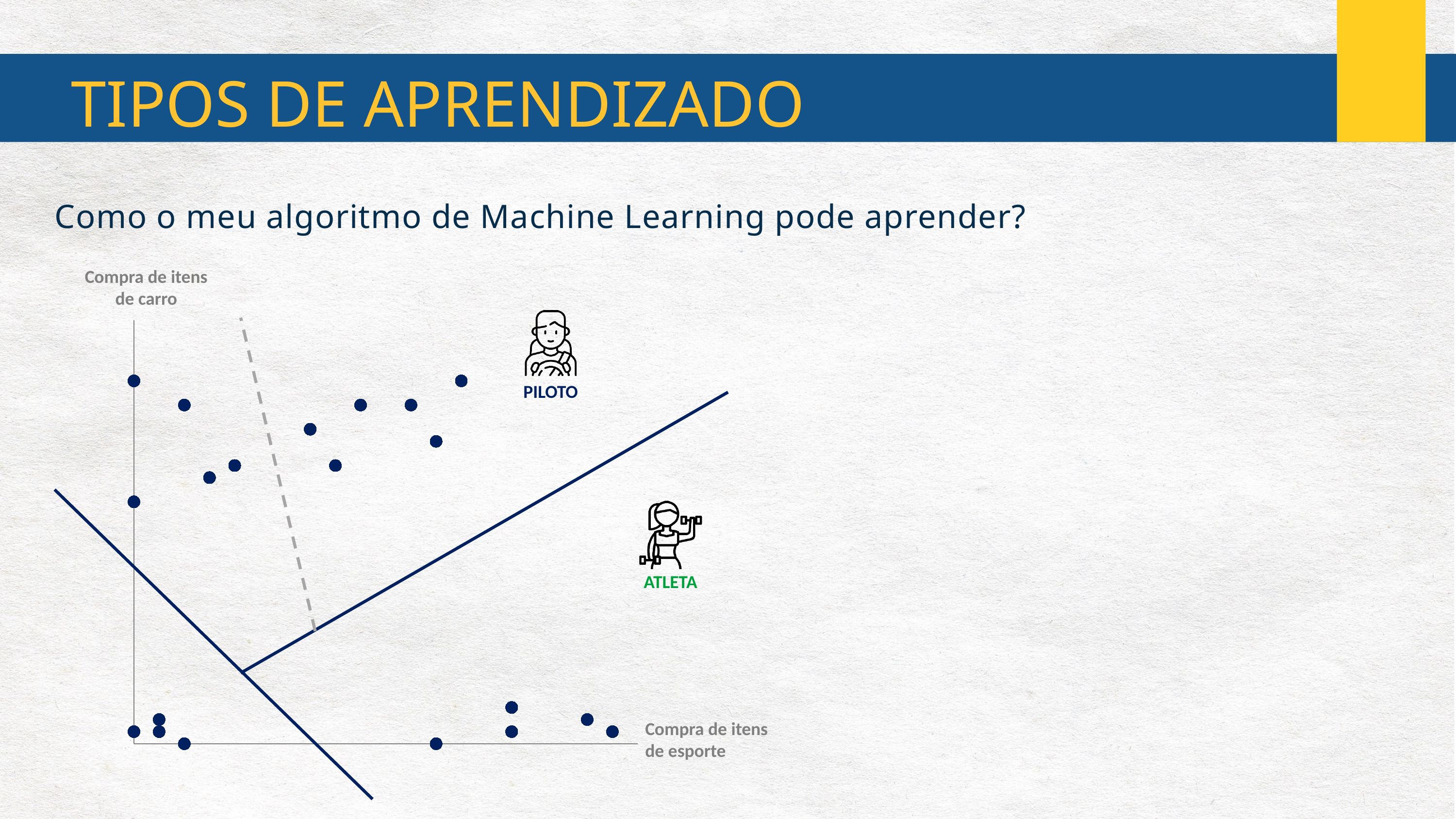
Which group of points, PILOTO or ATLETA, has higher values on the 'Compra de itens de carro' axis? PILOTO How many points are in the PILOTO cluster in the upper part of the chart? 11 What is the label of the horizontal axis of the chart? Compra de itens de esporte How many labeled groups of points are shown on the chart? 2 Which group of points, PILOTO or ATLETA, extends further along the 'Compra de itens de esporte' axis? ATLETA What is the label of the vertical axis of the chart? Compra de itens de carro What kind of chart is shown on the slide? scatter plot